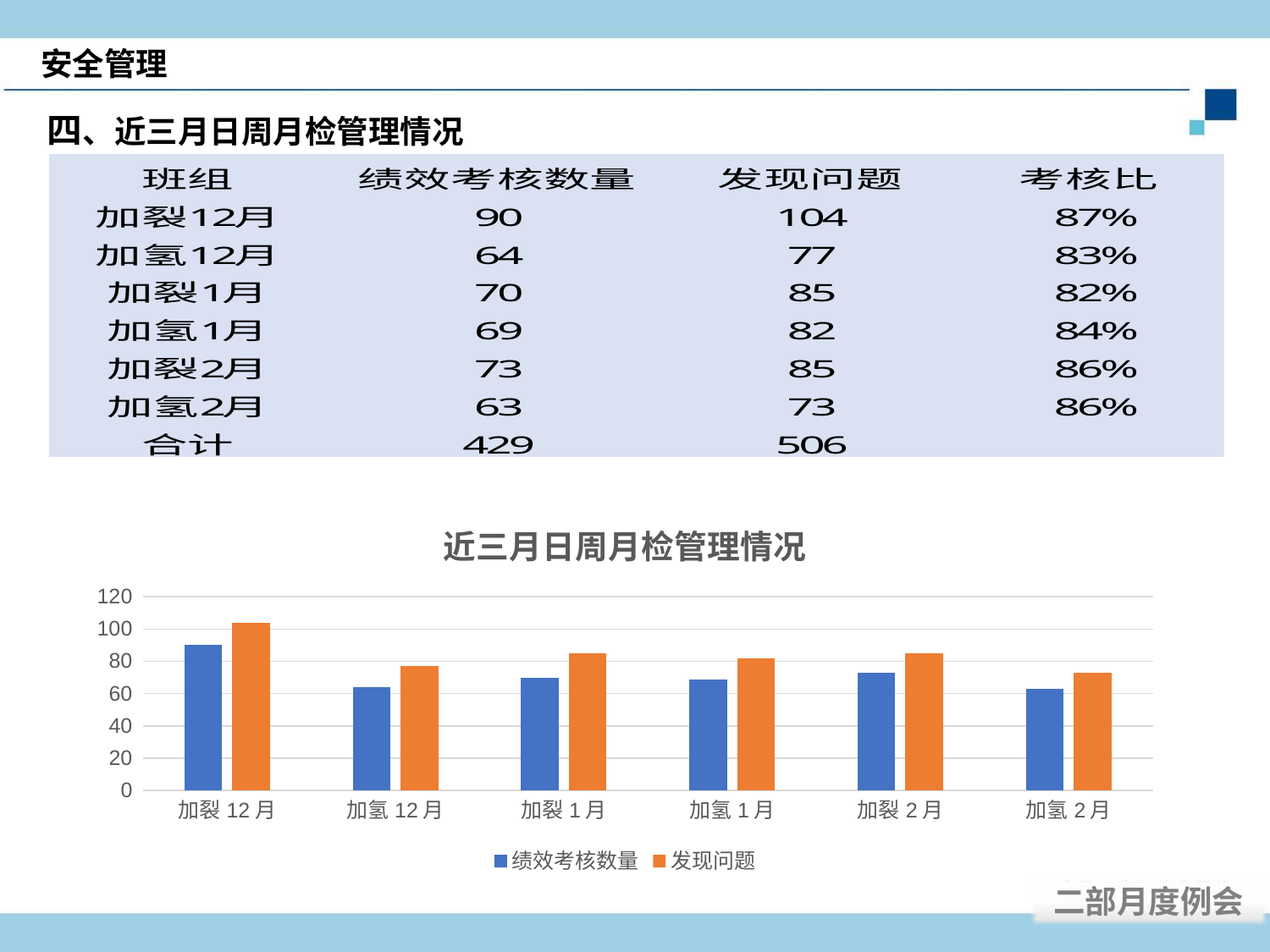
Which category has the lowest 绩效考核数量 value? 加氢 2月 What is the 发现问题 value for 加氢 2月? 73 Is the 发现问题 value for 加裂 12月 greater or less than 100? greater How many categories are shown on the x axis of the chart? 6 What is the 绩效考核数量 value for 加裂 12月? 90 Is the 绩效考核数量 value for 加氢 12月 greater or less than 80? less How many series does the chart legend list? 2 Which is larger for 加裂 1月: 绩效考核数量 or 发现问题? 发现问题 What is the difference between the 发现问题 and 绩效考核数量 values for 加裂 12月? 14 What kind of chart is shown on the slide? bar chart Which category has the highest 发现问题 value? 加裂 12月 What is the title of the chart? 近三月日周月检管理情况